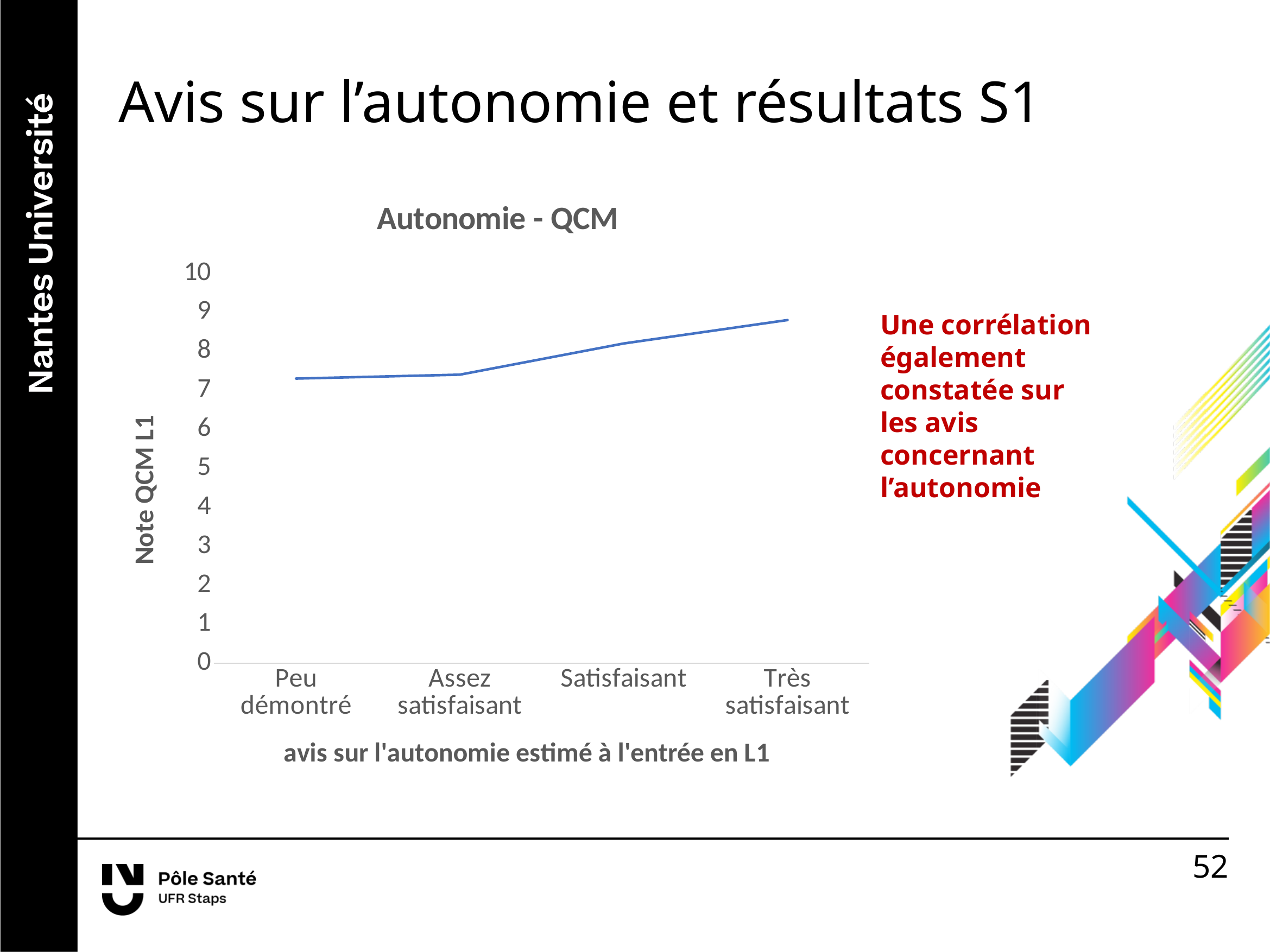
Is the value for Assez satisfaisant greater or less than 8? less What kind of chart is shown on the slide? line chart Which category has the highest Note QCM L1 value? Très satisfaisant Which is larger, the value for Très satisfaisant or the value for Peu démontré? Très satisfaisant What is the title of the chart? Autonomie - QCM How many categories are shown on the x axis of the chart? 4 Which category has the lowest Note QCM L1 value? Peu démontré Is the value for Très satisfaisant greater or less than 8? greater Do the values rise or fall along the x axis from Peu démontré to Très satisfaisant? rise Is the value for Peu démontré greater or less than 6? greater What is the label of the vertical axis of the chart? Note QCM L1 Which is larger, the value for Satisfaisant or the value for Assez satisfaisant? Satisfaisant